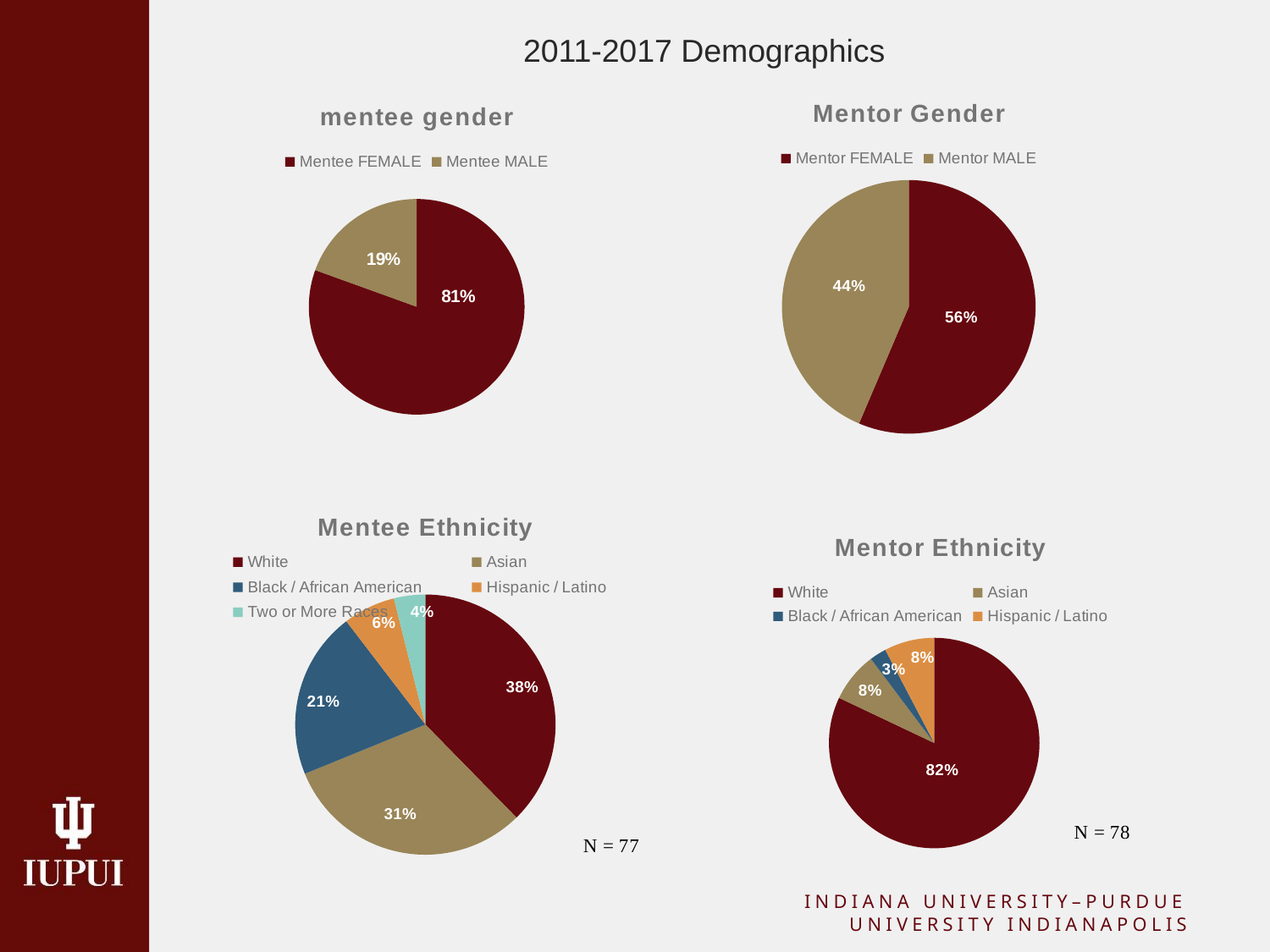
In the "Mentor Gender" chart, what is the value for Mentor FEMALE? 56% Which is larger: the White share in the "Mentee Ethnicity" chart or the White share in the "Mentor Ethnicity" chart? Mentor Ethnicity In the "mentee gender" chart, what share of the pie is Mentee FEMALE? 81% In the "Mentee Ethnicity" chart, which category has the largest share? White In the "mentee gender" chart, what is the value for Mentee MALE? 19% In the "Mentee Ethnicity" chart, what is the value for Black / African American? 21% In the "Mentor Gender" chart, what is the difference between Mentor FEMALE and Mentor MALE? 12% In the "Mentee Ethnicity" chart, which category has the smallest share? Two or More Races In the "Mentee Ethnicity" chart, how many categories does the legend list? 5 In the "Mentor Ethnicity" chart, what is the value for Black / African American? 3% What type of chart is the "Mentor Gender" chart? Pie chart In the "Mentor Ethnicity" chart, what is the value for White? 82%